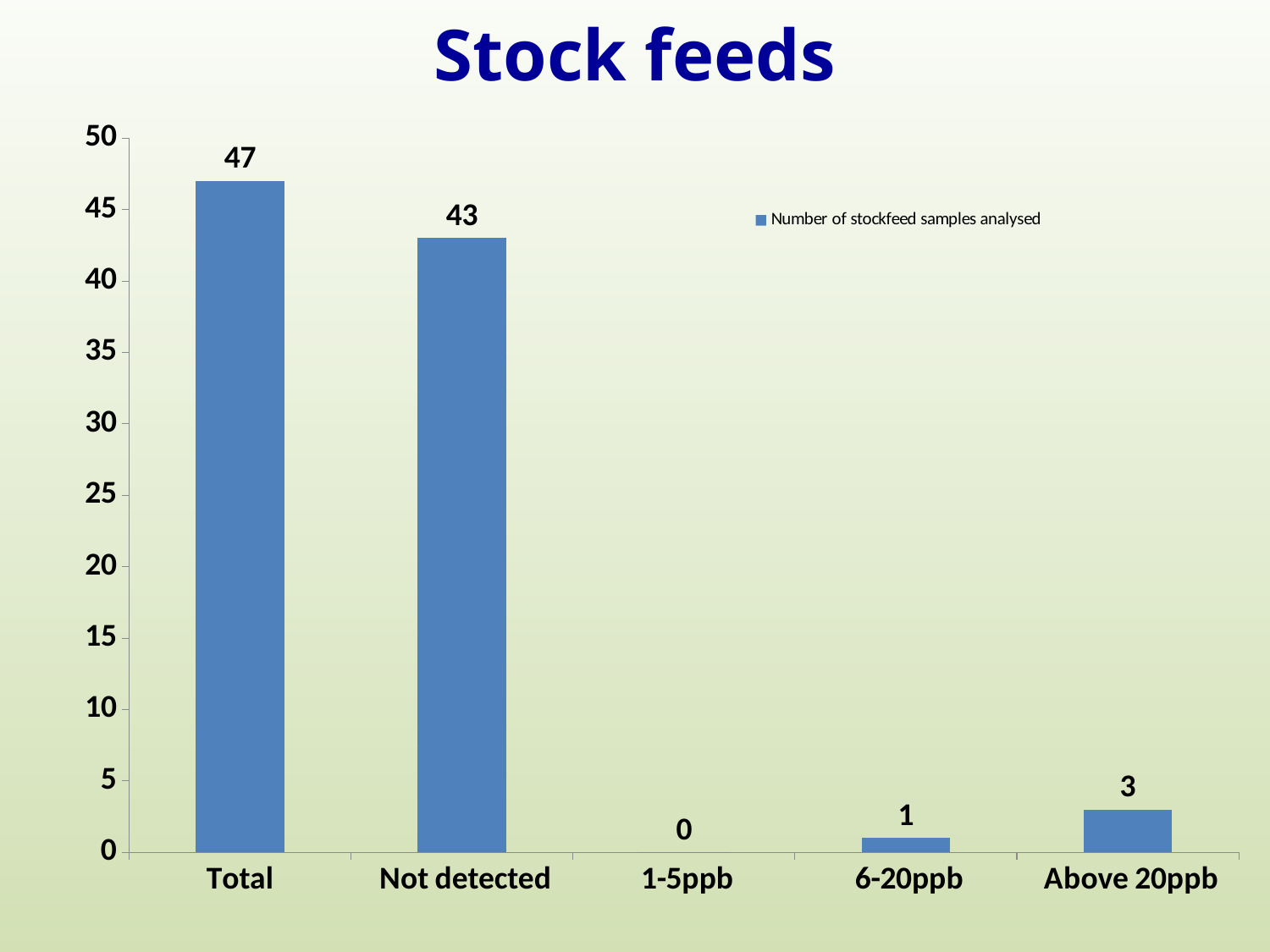
How many categories are shown on the x axis? 5 What is the value for Not detected? 43 What is the value for Total? 47 Is the value for Not detected greater or less than 40? greater What series name does the legend show? Number of stockfeed samples analysed Which category has the lowest value? 1-5ppb What is the value for 1-5ppb? 0 What kind of chart is shown on the slide? bar chart Which is larger, the value for 6-20ppb or the value for Above 20ppb? Above 20ppb What is the value for Above 20ppb? 3 What is the difference between the values for Total and Not detected? 4 Which category has the highest value? Total